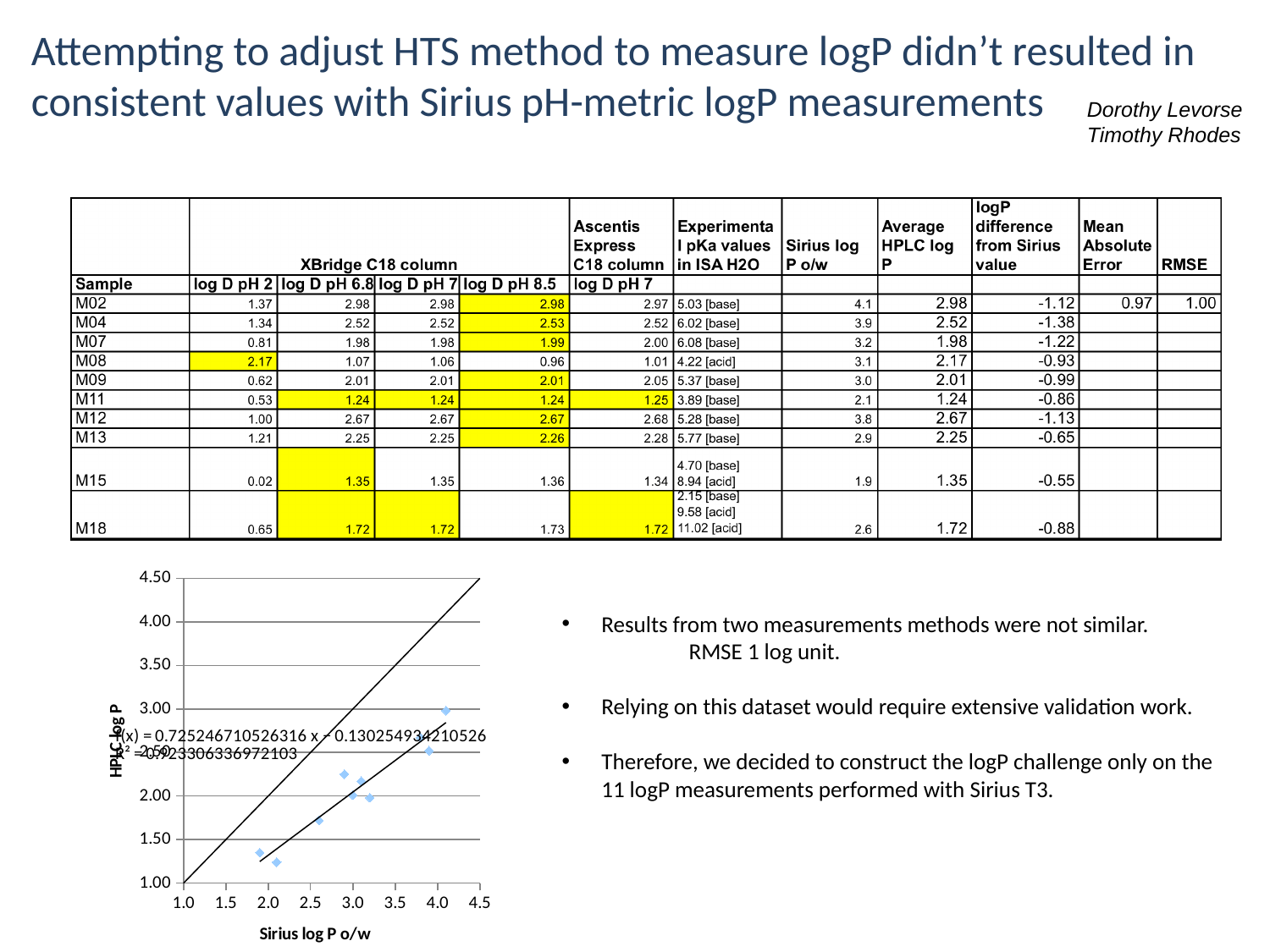
Is the HPLC log P value of the point with the highest Sirius log P o/w greater or less than 2.50? greater What kind of chart is shown on the slide? scatter chart Is the HPLC log P value of the point at Sirius log P o/w of about 2.6 greater or less than 2.00? less What is the title of the x axis of the scatter chart? Sirius log P o/w What is the lowest value shown on the x axis of the scatter chart? 1.0 How many data points are plotted on the scatter chart? 10 What is the title of the y axis of the scatter chart? HPLC log P What is the slope of the fitted trendline equation shown on the scatter chart? 0.725246710526316 Are any of the plotted points above 3.50 on the HPLC log P axis? No Do the plotted HPLC log P values generally rise or fall as Sirius log P o/w increases? rise What is the highest value shown on the y axis of the scatter chart? 4.50